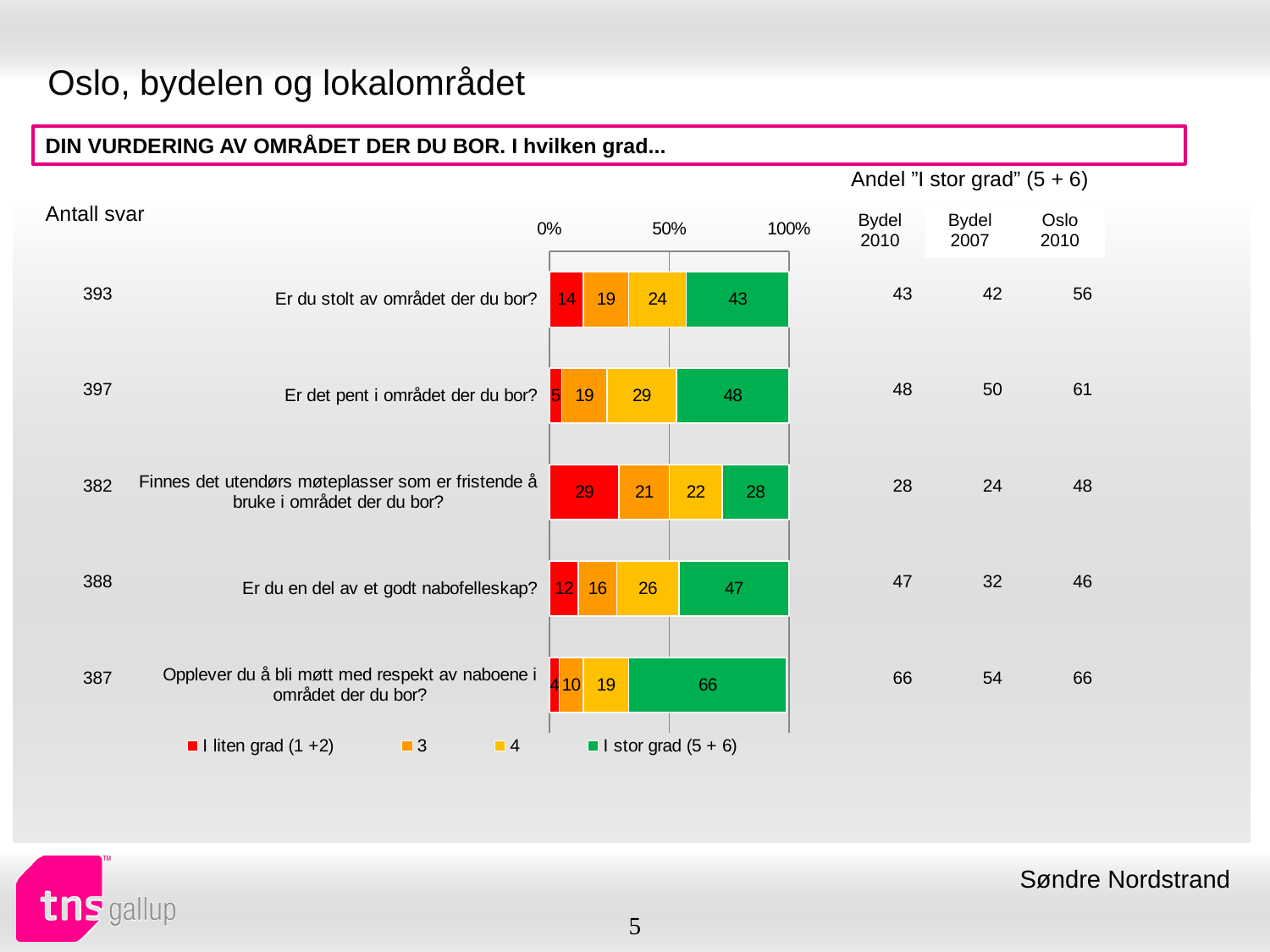
What is the value of series "4" for "Er det pent i området der du bor?"? 29 How many categories (questions) are plotted in the chart? 5 What is the value of "I stor grad (5 + 6)" for "Er du stolt av området der du bor?"? 43 What kind of chart is shown on the slide? Stacked bar chart What is the difference between the "I stor grad (5 + 6)" values for "Er du en del av et godt nabofelleskap?" and "Er du stolt av området der du bor?"? 4 Which category has the lowest value for "I stor grad (5 + 6)"? Finnes det utendørs møteplasser som er fristende å bruke i området der du bor? What is the total of the stacked bar for "Opplever du å bli møtt med respekt av naboene i området der du bor?"? 99 Which category has the highest value for "I stor grad (5 + 6)"? Opplever du å bli møtt med respekt av naboene i området der du bor? Which is larger: the "I liten grad (1 +2)" value for "Er du stolt av området der du bor?" or for "Er det pent i området der du bor?"? Er du stolt av området der du bor? Which series is shown in green in the legend? I stor grad (5 + 6) What is the value of "I liten grad (1 +2)" for "Finnes det utendørs møteplasser som er fristende å bruke i området der du bor?"? 29 How many series does the legend list? 4